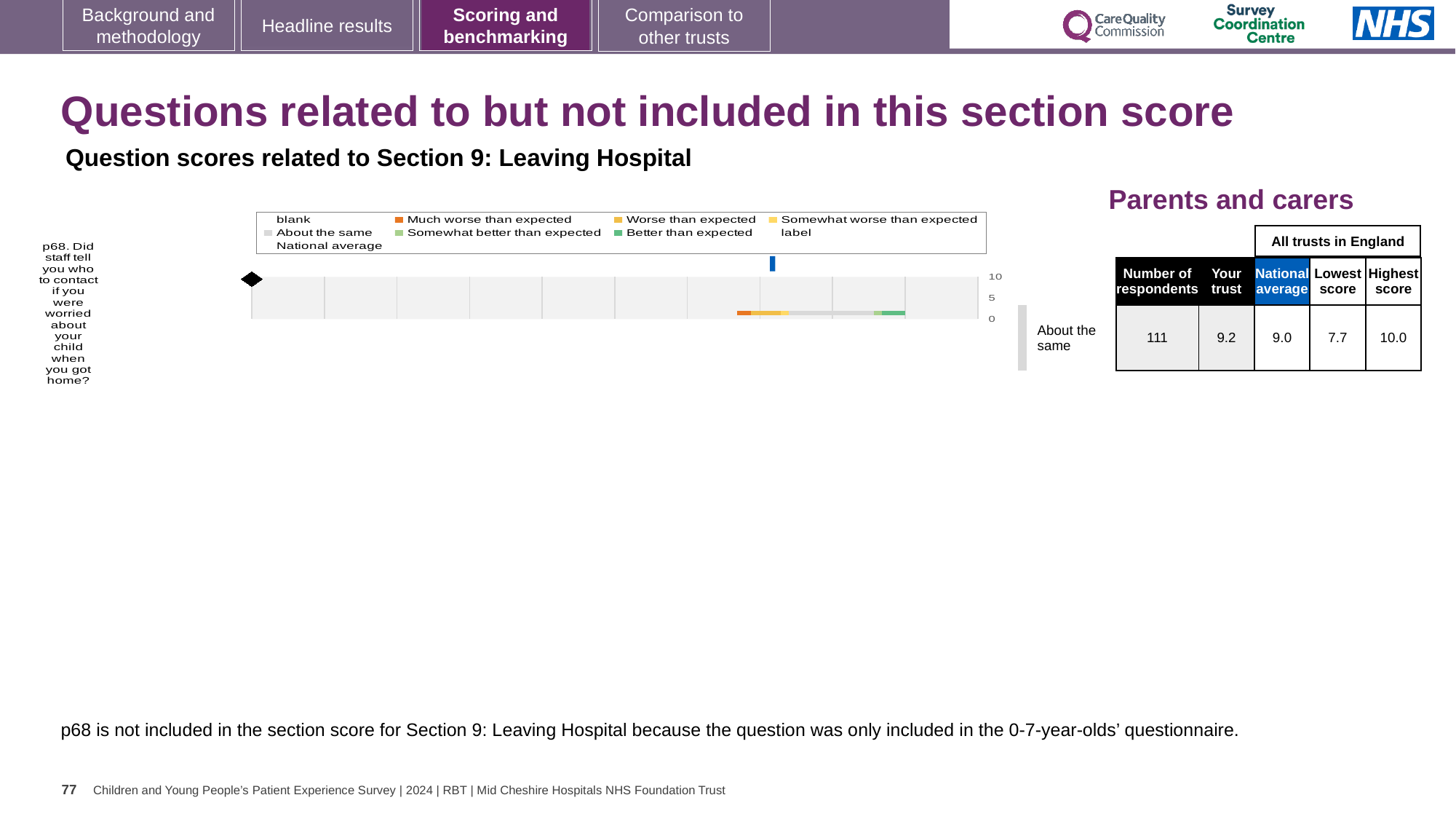
Which is larger for p68, the 'Your trust' score or the national average? Your trust What is the difference between the highest and lowest scores for p68 across all trusts in England? 2.3 What benchmark category is shown for p68 next to the chart? About the same How many respondents answered p68? 111 How many questions are plotted in the chart? 1 What is the lowest score among all trusts in England for p68? 7.7 What kind of chart is used to show the p68 question score? bar chart Which question is plotted in the chart? p68. Did staff tell you who to contact if you were worried about your child when you got home? What is the 'Your trust' score for p68? 9.2 What is the national average score for p68? 9.0 What is the difference between the 'Your trust' score and the national average for p68? 0.2 What is the highest score among all trusts in England for p68? 10.0